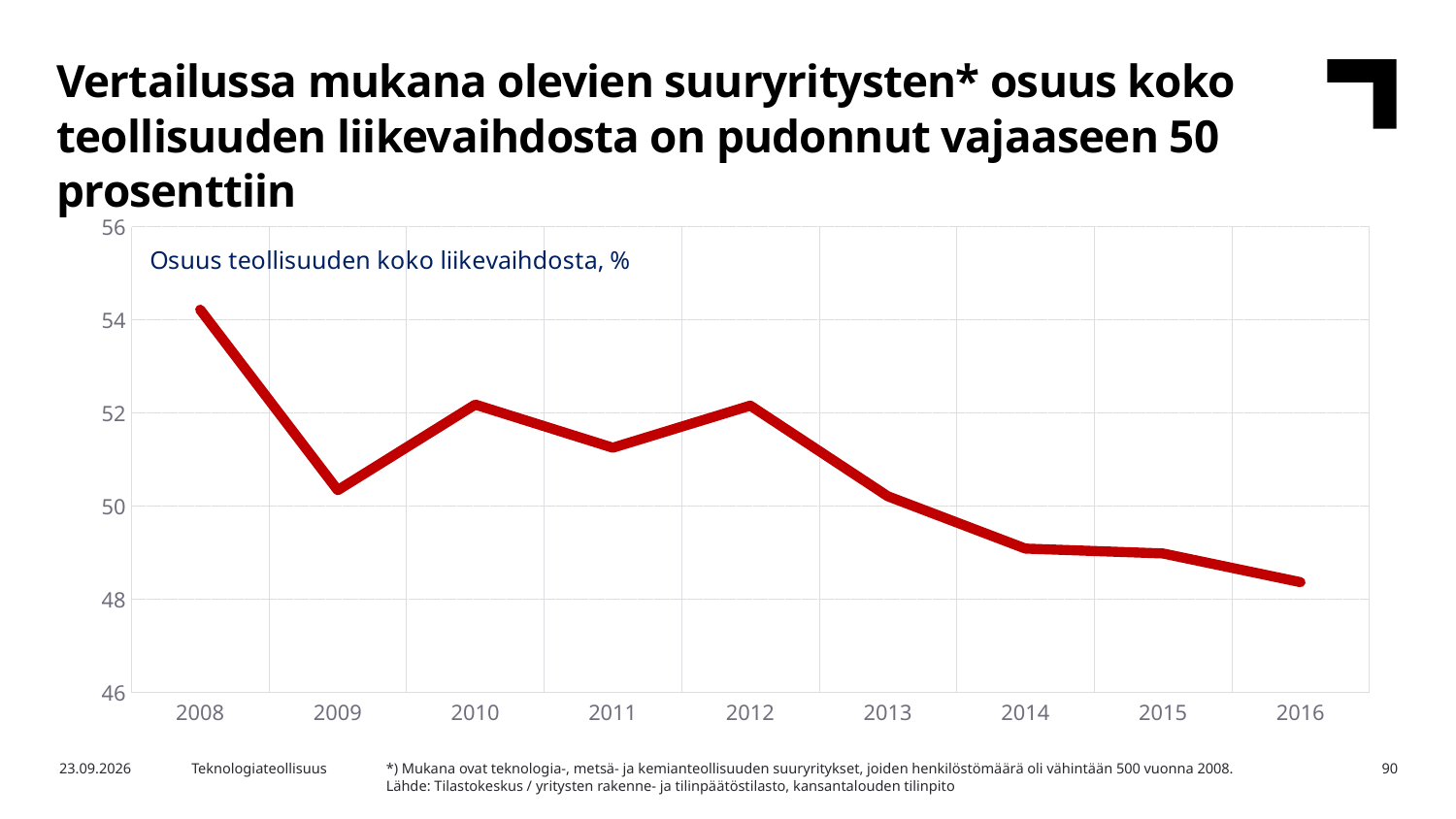
Which year has the highest value in the chart? 2008 What is the label shown inside the chart area describing the plotted series? Osuus teollisuuden koko liikevaihdosta, % What kind of chart is shown on the slide? line chart Is the value for 2016 greater or less than 50? less Is the value for 2014 greater or less than 50? less Is the value for 2010 greater or less than 52? greater Which year has the lowest value in the chart? 2016 Which is larger, the value for 2013 or the value for 2016? 2013 Overall, do the values rise or fall from 2008 to 2016? fall How many years are plotted along the x axis of the chart? 9 Which is larger, the value for 2008 or the value for 2009? 2008